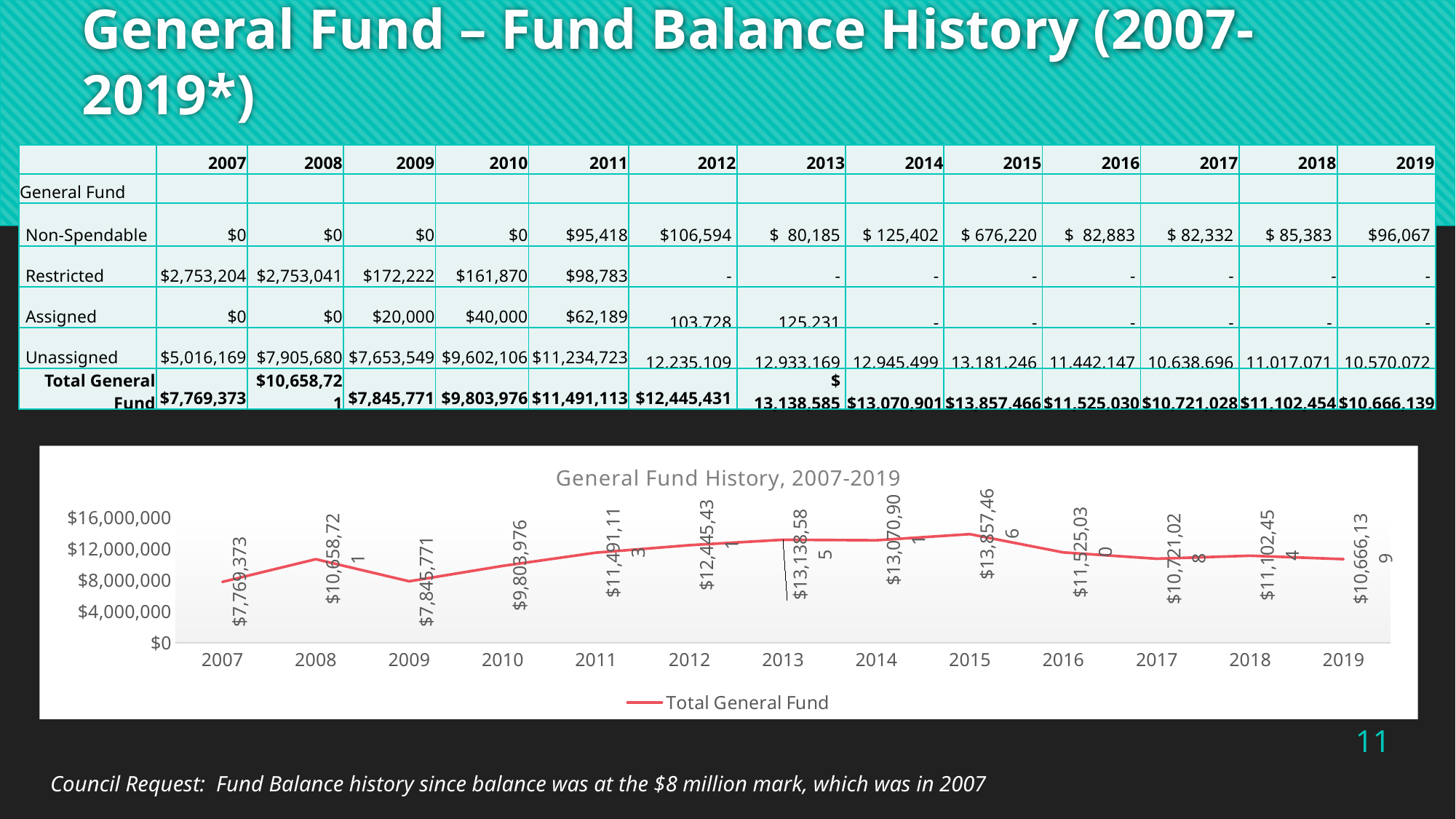
How many series does the chart legend list? 1 Which year has the lowest Total General Fund value in the chart? 2007 What is the difference between the Total General Fund values for 2015 and 2016? $2,332,436 Which year has the highest Total General Fund value in the chart? 2015 What is the Total General Fund value for 2007 in the chart? $7,769,373 What is the title of the chart? General Fund History, 2007-2019 What is the Total General Fund value for 2015 in the chart? $13,857,466 What is the Total General Fund value for 2019 in the chart? $10,666,139 Which is larger, the Total General Fund value for 2008 or for 2009? 2008 How many years are plotted on the x axis of the chart? 13 What type of chart is shown on the slide? line chart Does the Total General Fund value rise or fall from 2015 to 2017? fall